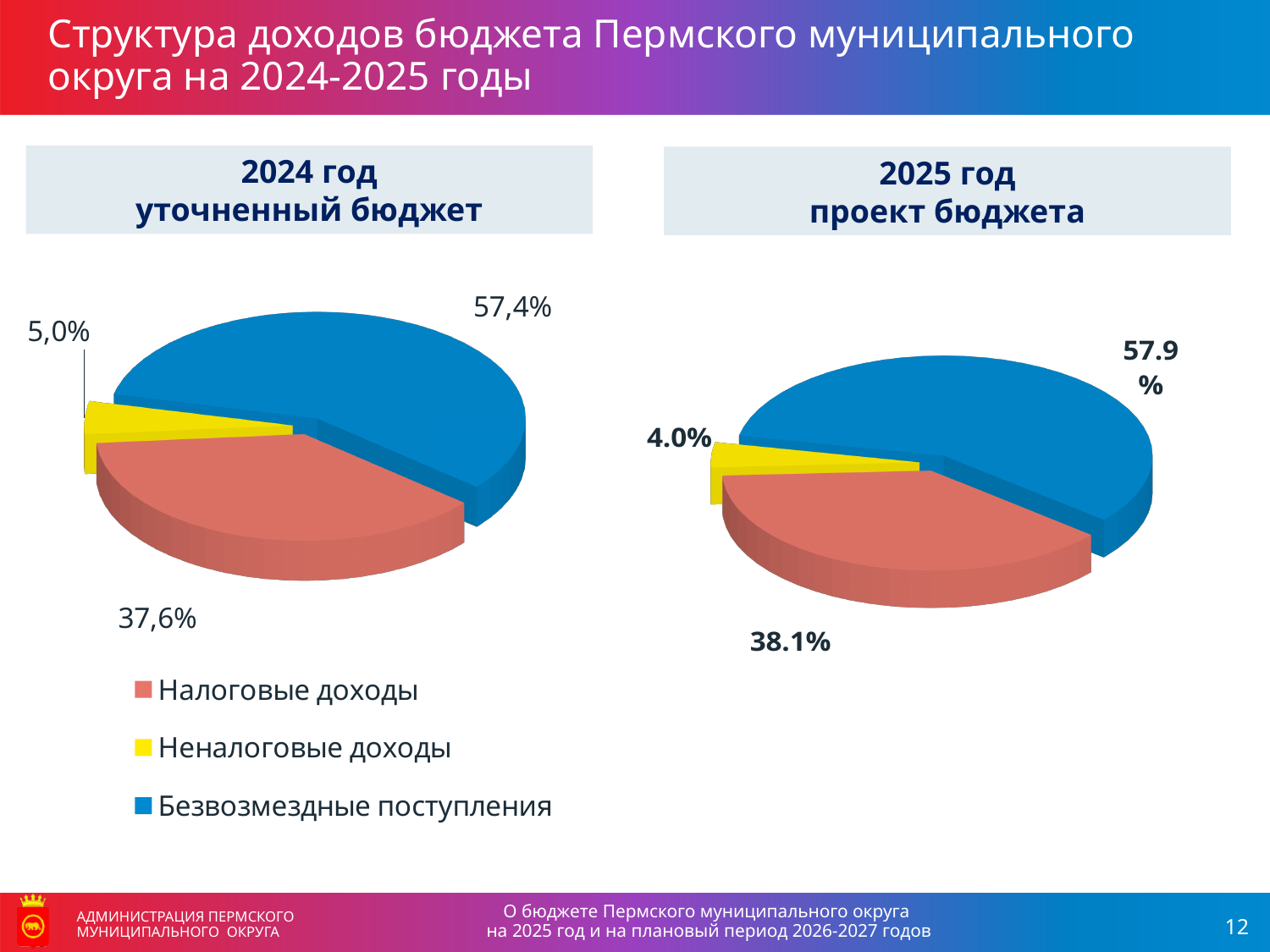
In the 2025 год проект бюджета chart, which category has the smallest share? Неналоговые доходы Which colour represents Неналоговые доходы in the pie charts? Yellow In the 2024 год уточненный бюджет chart, what share is Налоговые доходы? 37,6% In the 2025 год проект бюджета chart, what share is Неналоговые доходы? 4.0% In the 2024 год уточненный бюджет chart, what share is Безвозмездные поступления? 57,4% In the 2024 год уточненный бюджет chart, which is larger: Налоговые доходы or Безвозмездные поступления? Безвозмездные поступления In the 2024 год уточненный бюджет chart, what share is Неналоговые доходы? 5,0% In the 2024 год уточненный бюджет chart, which category has the largest share? Безвозмездные поступления In the 2025 год проект бюджета chart, what share is Налоговые доходы? 38.1% What kind of chart is used for the 2024 год уточненный бюджет? Pie chart How many categories does the legend list for the pie charts? 3 In the 2025 год проект бюджета chart, what share is Безвозмездные поступления? 57.9%